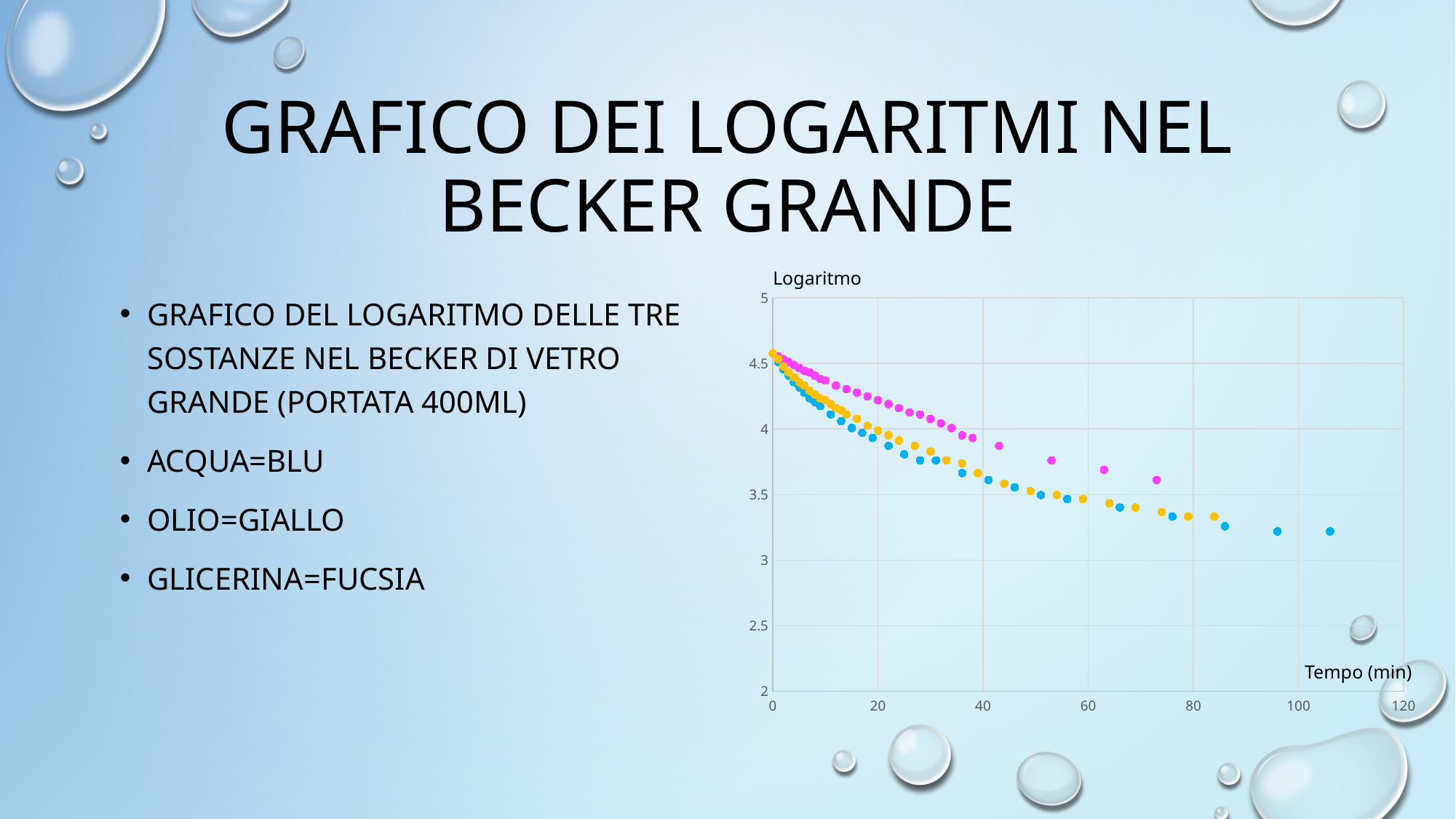
Is the fuchsia (glicerina) value at about 53 minutes greater or less than 4? less Is the blue (acqua) value at about 40 minutes greater or less than 4? less Is the blue (acqua) value at about 100 minutes greater or less than 3.5? less Do the plotted values rise or fall as time increases along the x axis? fall Which series has the highest values at 40 minutes: blue, yellow or fuchsia? fuchsia What is the label shown above the y axis of the chart? Logaritmo What kind of chart is shown on the slide? scatter chart What is the label of the x axis of the chart? Tempo (min) Which series has the lowest values at 60 minutes: blue, yellow or fuchsia? blue How many data series (colours) are plotted on the chart? 3 At 60 minutes, is the fuchsia (glicerina) value larger or smaller than the blue (acqua) value? larger